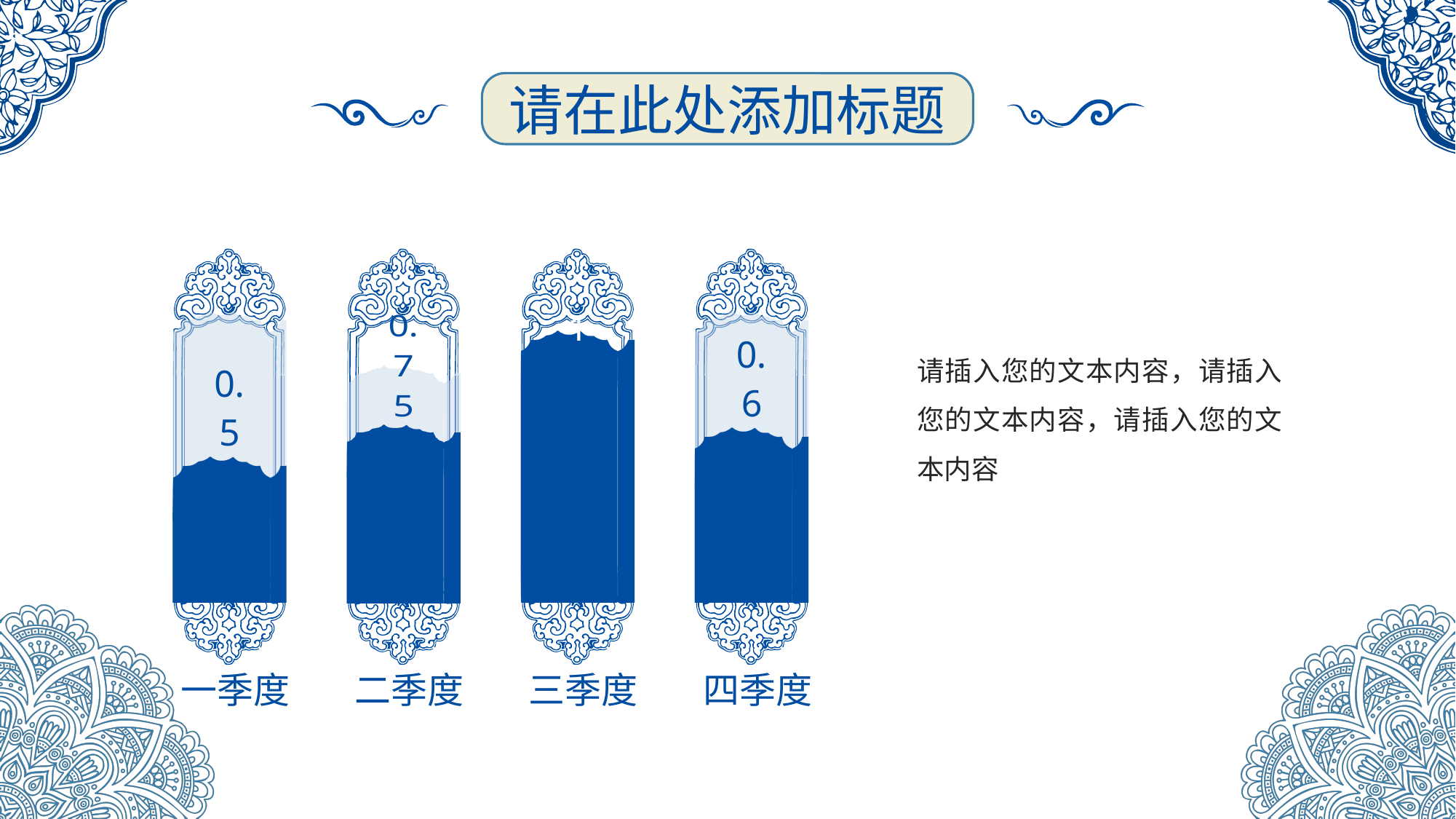
What kind of chart is shown on the slide? bar chart What is the value for 一季度? 0.5 What is the difference between the values for 二季度 and 一季度? 0.25 What is the difference between the values for 四季度 and 一季度? 0.1 What is the value for 四季度? 0.6 What is the value for 二季度? 0.75 Which quarter has the lowest value? 一季度 Which quarter has the highest value? 三季度 How many categories are shown in the chart? 4 Which is larger, the value for 二季度 or the value for 四季度? 二季度 What is the value for 三季度? 1 What is the title shown at the top of the slide? 请在此处添加标题